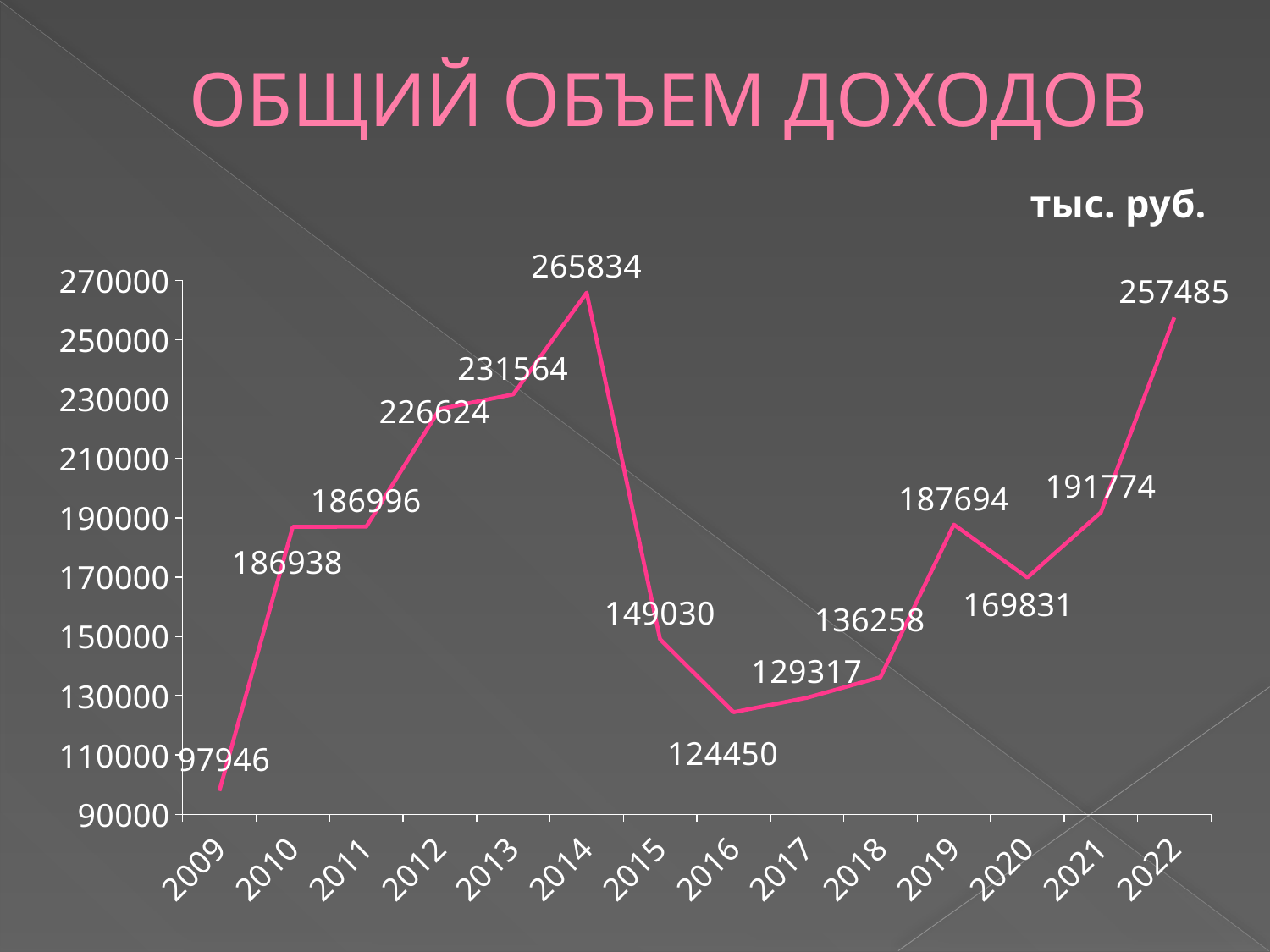
Is the value for 2018 greater or less than 150000? less Which year has the lowest value? 2009 What is the value for 2014? 265834 What type of chart is shown on the slide? line chart What is the title of the chart? ОБЩИЙ ОБЪЕМ ДОХОДОВ What is the difference between the values for 2022 and 2021? 65711 What is the difference between the values for 2014 and 2015? 116804 What is the value for 2016? 124450 How many years are plotted on the x axis? 14 Which year has the highest value? 2014 Which year has the larger value, 2019 or 2020? 2019 What is the value for 2022? 257485